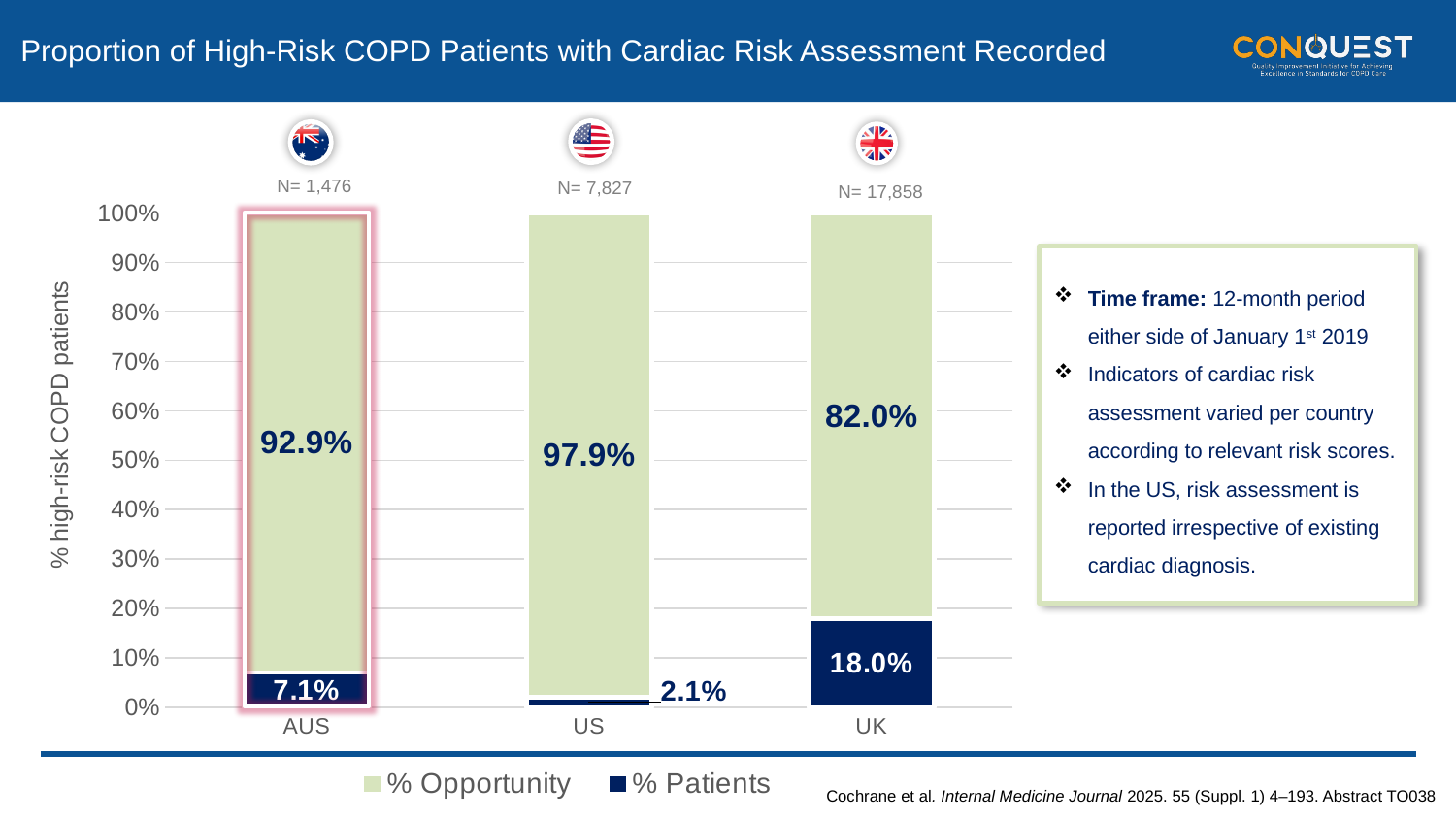
Which country has the highest % Patients value? UK How many countries are shown on the x axis? 3 What is the % Opportunity value for AUS? 92.9% How many series does the legend list? 2 What is the title of the chart? Proportion of High-Risk COPD Patients with Cardiac Risk Assessment Recorded What is the % Patients value for the US? 2.1% Which country has the highest % Opportunity value? US Is the % Patients value for AUS larger or smaller than the % Patients value for the UK? smaller What is the difference between the % Patients values for the UK and AUS? 10.9% What kind of chart is shown? stacked bar chart Which country has the lowest % Patients value? US What is the % Patients value for the UK? 18.0%